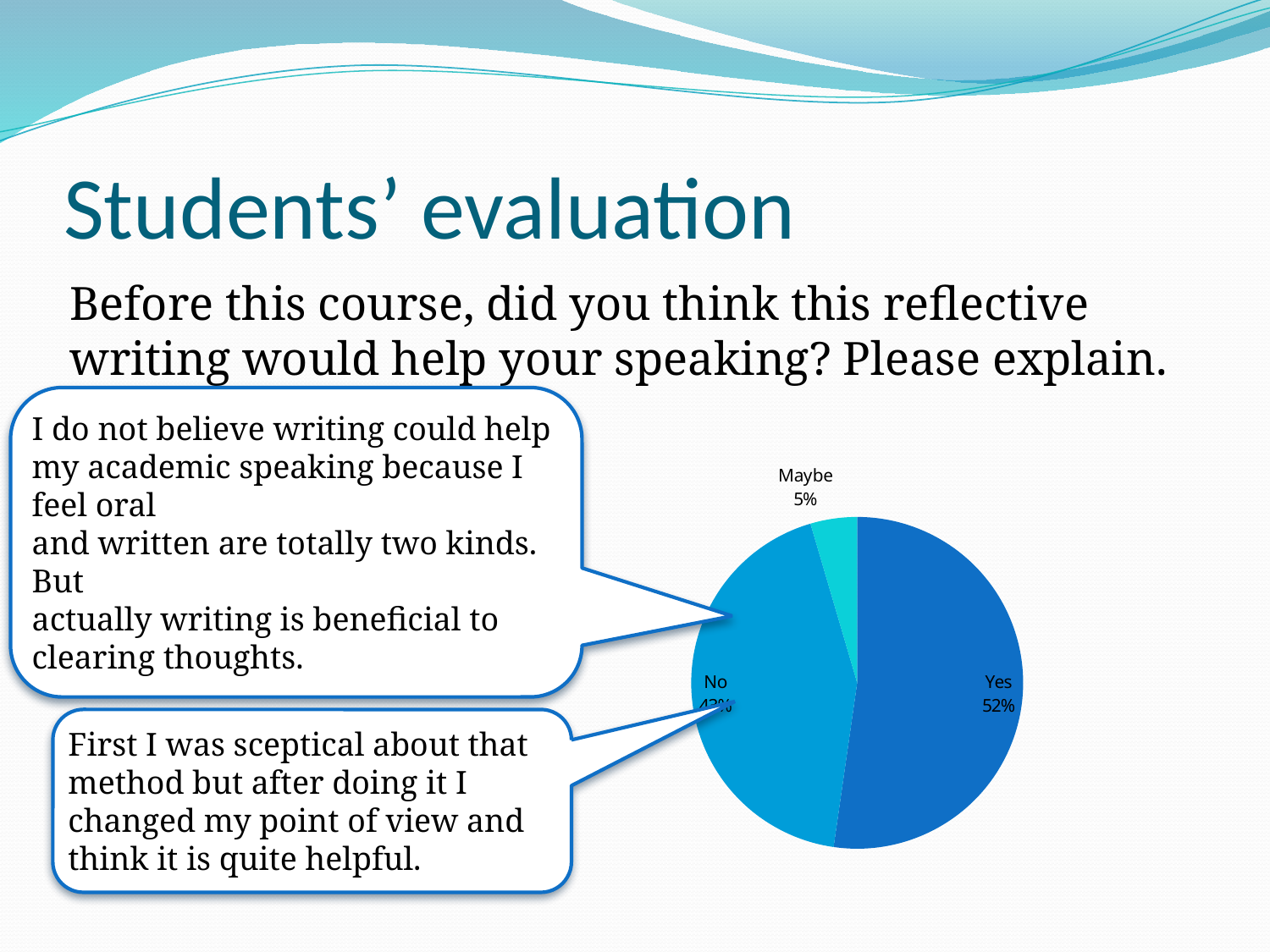
What percentage of students answered "Maybe" in the pie chart? 5% Which slice is larger in the pie chart, "Yes" or "No"? Yes Which slice is larger in the pie chart, "No" or "Maybe"? No What kind of chart is shown on the slide? pie chart What question do the pie chart responses answer, according to the slide? Before this course, did you think this reflective writing would help your speaking? How many slices does the pie chart have? 3 Which response has the largest slice of the pie chart? Yes What share of the pie does the "Yes" slice represent? 52% What is the difference in percentage points between the "Yes" and "Maybe" slices? 47 Is the "Yes" slice more or less than half of the pie? more What percentage of students answered "Yes" in the pie chart? 52% Which response has the smallest slice of the pie chart? Maybe